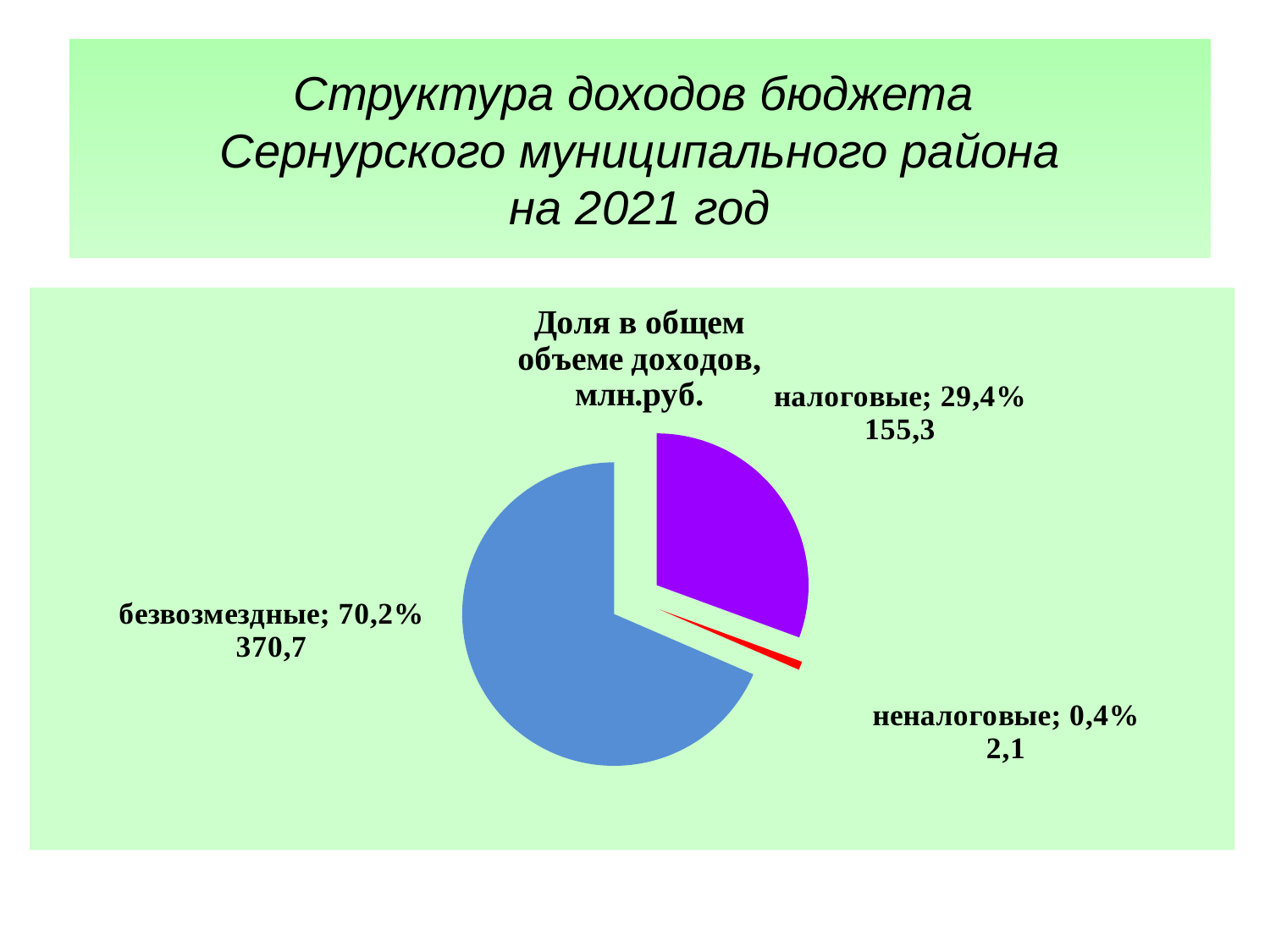
What is the value in млн.руб. for неналоговые? 2,1 What is the title of the pie chart? Доля в общем объеме доходов, млн.руб. What share of total revenue do налоговые make up? 29,4% Which category has the largest share of revenue? безвозмездные What share of total revenue do безвозмездные make up? 70,2% What share of total revenue do неналоговые make up? 0,4% What kind of chart is shown on the slide? pie chart What is the value in млн.руб. for налоговые? 155,3 What is the value in млн.руб. for безвозмездные? 370,7 Which category has the smallest share of revenue? неналоговые How many slices does the pie chart have? 3 Which is larger, налоговые or неналоговые? налоговые